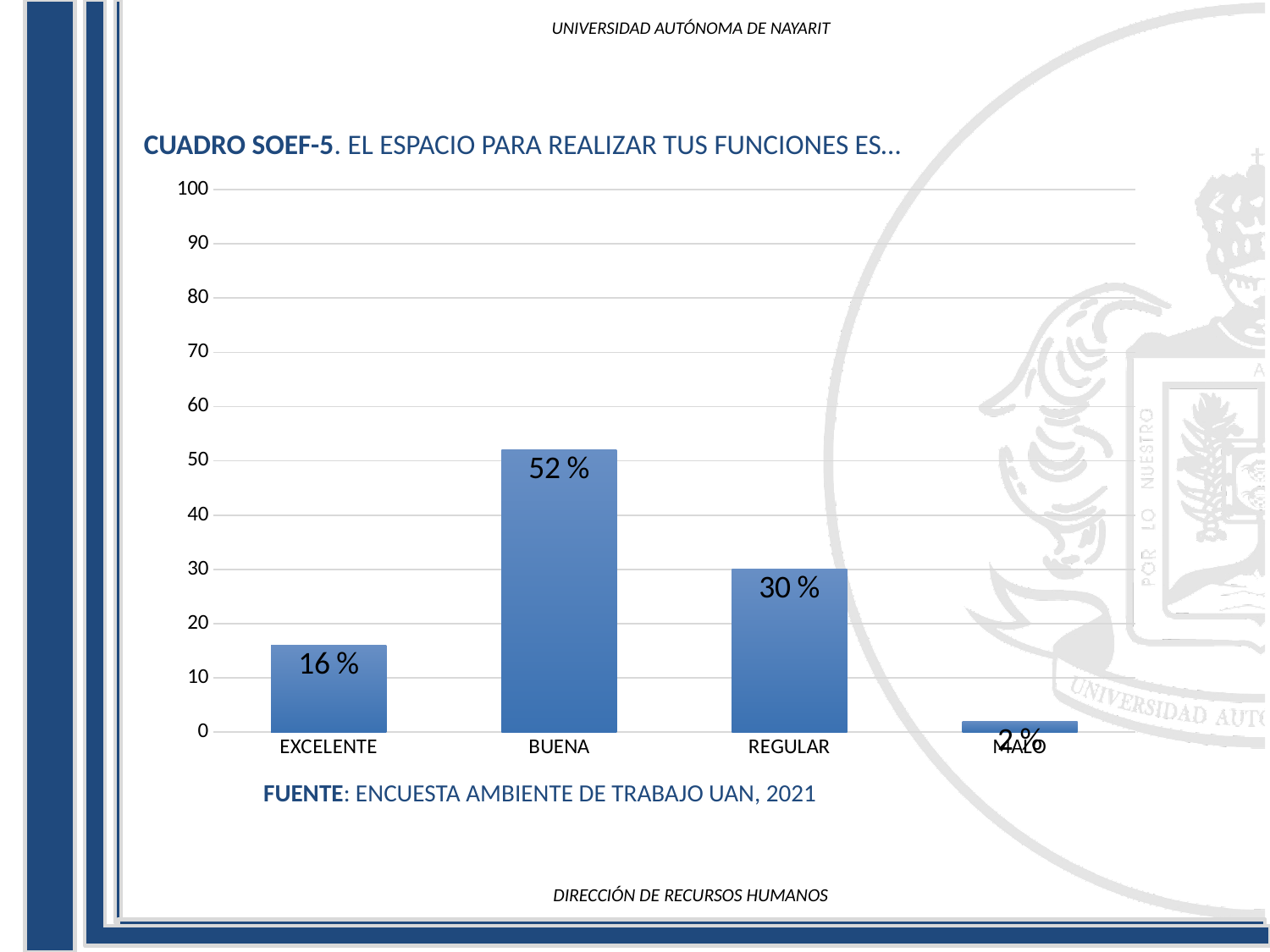
What is the value for REGULAR? 30 % What kind of chart is shown on the slide? bar chart Is the value for BUENA greater or less than 50? greater Which is larger, the value for EXCELENTE or the value for REGULAR? REGULAR What is the value for MALO? 2 % What source is cited below the chart? ENCUESTA AMBIENTE DE TRABAJO UAN, 2021 Which category has the lowest value? MALO Which category has the highest value? BUENA What is the value for EXCELENTE? 16 % What is the difference between the values for BUENA and REGULAR? 22 % What is the value for BUENA? 52 % How many categories are shown on the x axis? 4